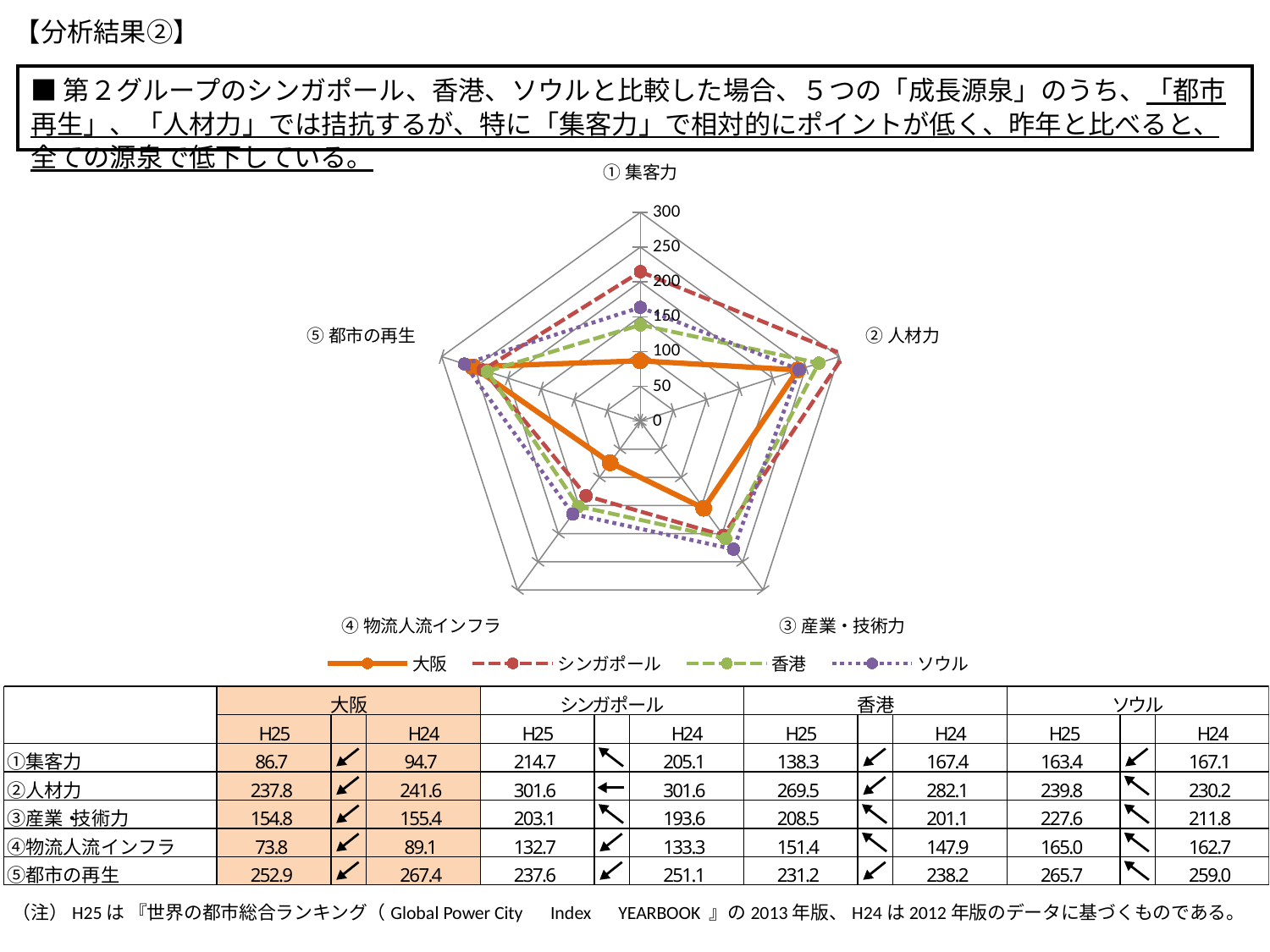
Is the value for シンガポール on the ① 集客力 axis greater or less than 200? greater Is the value for 大阪 on the ② 人材力 axis greater or less than 200? greater How many axes (categories) does the radar chart have? 5 What kind of chart is shown on the slide? radar chart Is the value for 大阪 on the ① 集客力 axis greater or less than 100? less According to the table below the chart, what is the H25 value of ⑤都市の再生 for ソウル? 265.7 On the ① 集客力 axis, which is larger: 大阪 or 香港? 香港 Which city has the lowest value on the ④ 物流人流インフラ axis of the radar chart? 大阪 According to the table below the chart, what is the H25 value of ①集客力 for 大阪? 86.7 According to the table, what is the difference between the H24 and H25 values of ①集客力 for 大阪? 8.0 Which city has the highest value on the ① 集客力 axis of the radar chart? シンガポール How many series does the chart legend list? 4